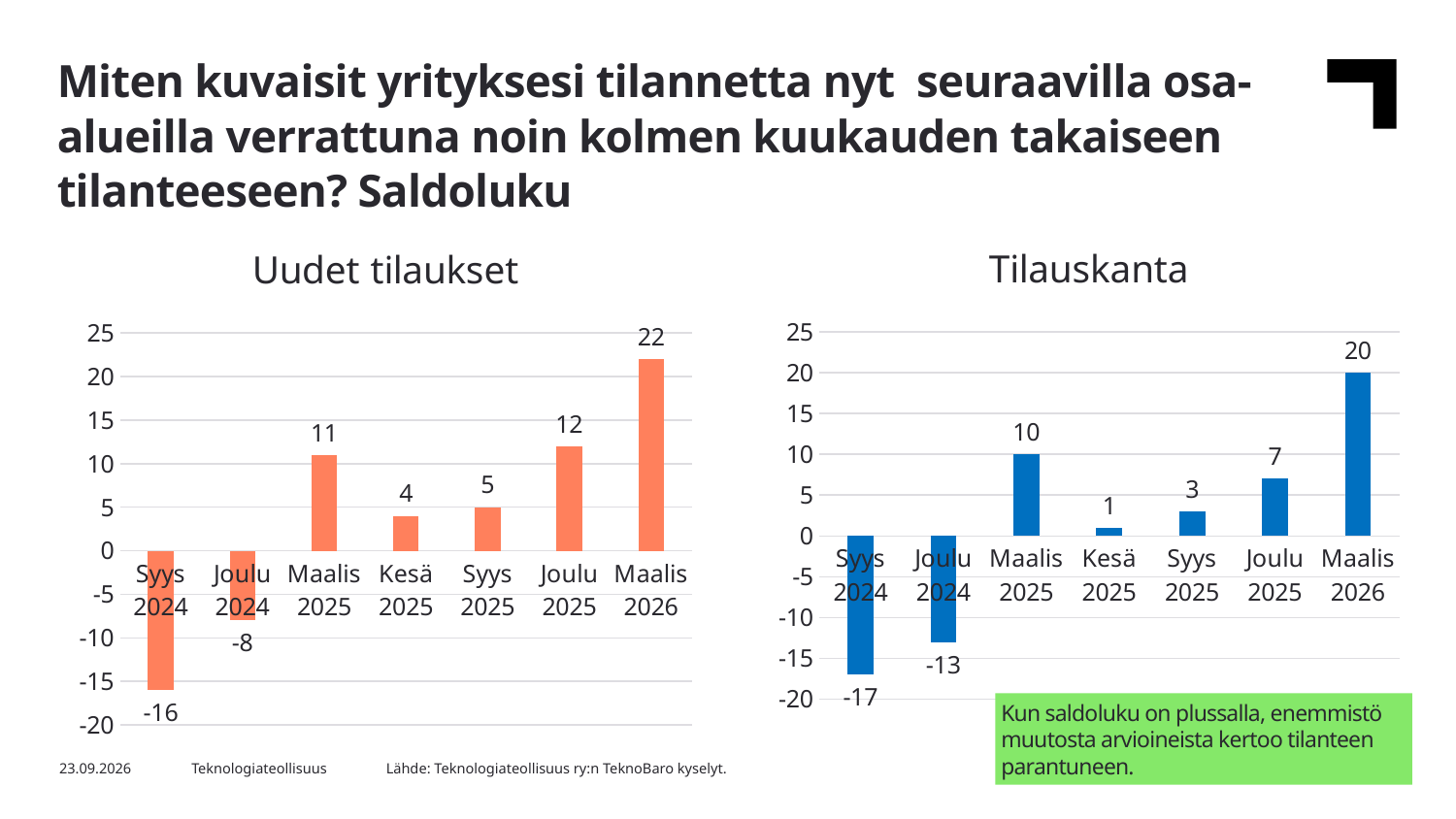
In the 'Tilauskanta' chart, what is the value for Joulu 2025? 7 In the 'Uudet tilaukset' chart, which period has the highest value? Maalis 2026 In the 'Uudet tilaukset' chart, which is larger, the value for Maalis 2025 or the value for Joulu 2025? Joulu 2025 In the 'Tilauskanta' chart, which period has the lowest value? Syys 2024 What kind of chart is the 'Uudet tilaukset' chart? Bar chart In the 'Uudet tilaukset' chart, what is the difference between the values for Maalis 2026 and Joulu 2025? 10 In the 'Tilauskanta' chart, what is the difference between the values for Maalis 2025 and Syys 2025? 7 In the 'Tilauskanta' chart, what is the value for Kesä 2025? 1 How many periods are shown on the x axis of the 'Tilauskanta' chart? 7 In the 'Uudet tilaukset' chart, what is the value for Syys 2024? -16 In the 'Uudet tilaukset' chart, what is the value for Maalis 2026? 22 In the 'Tilauskanta' chart, do the values generally rise or fall from Syys 2024 to Maalis 2025? Rise